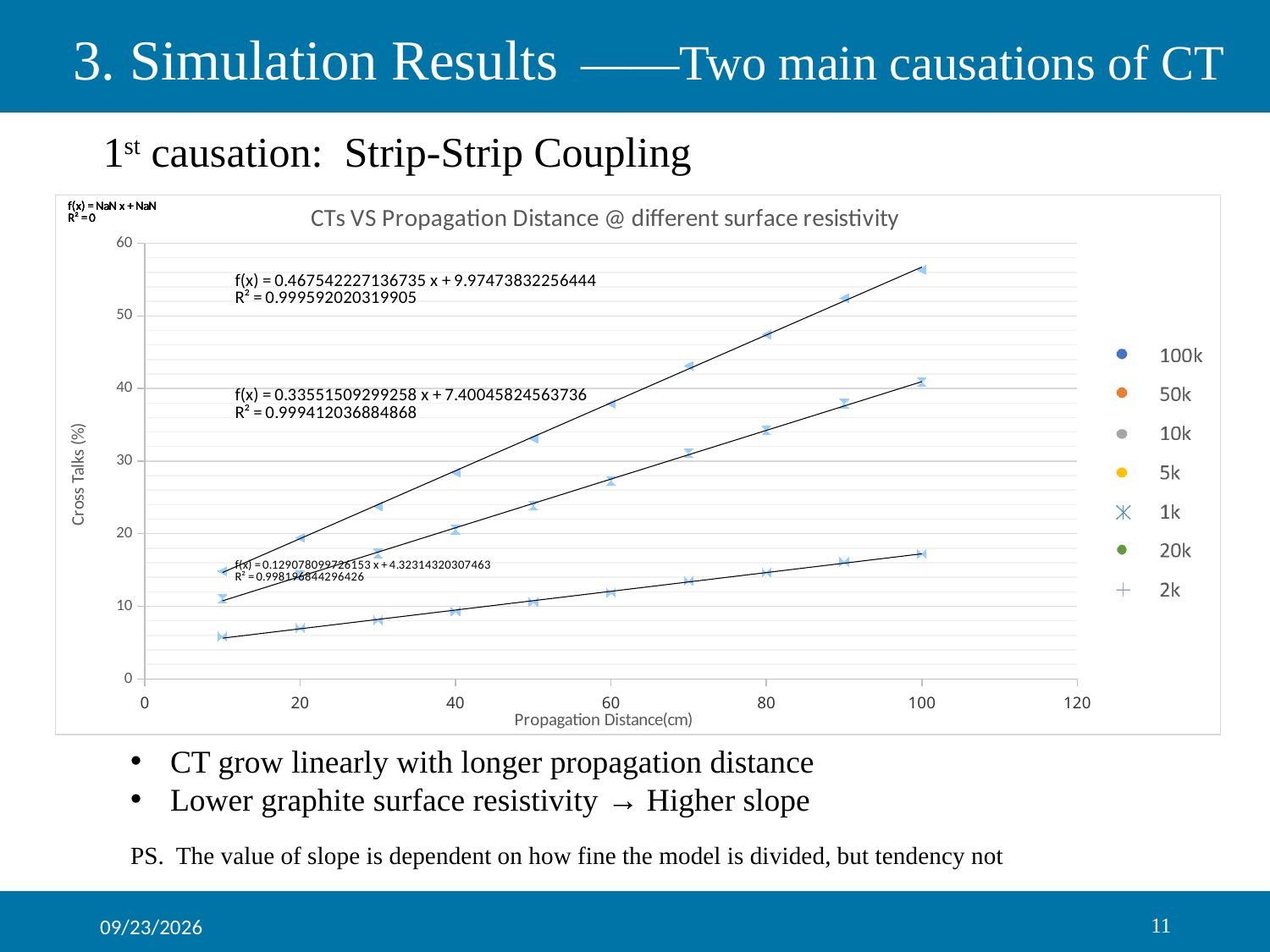
Is the cross talk value of the lowest series at 100 cm greater or less than 20? less What is the title of the chart? CTs VS Propagation Distance @ different surface resistivity What is the R² value printed for the middle trend line (slope 0.33551509299258)? 0.999412036884868 How many series does the legend list? 7 Which trend line has the larger printed slope, the topmost one or the middle one? the topmost one What kind of chart is shown? scatter chart What is the slope printed in the equation of the topmost trend line? 0.467542227136735 Do the cross talk values rise or fall as propagation distance increases? rise What is the intercept printed in the equation of the middle trend line (f(x) = 0.33551509299258 x + ...)? 7.40045824563736 Is the cross talk value of the topmost series at 100 cm greater or less than 50? greater What is the label of the x axis? Propagation Distance(cm) What is the R² value printed for the topmost trend line (the one with slope 0.467542227136735)? 0.999592020319905